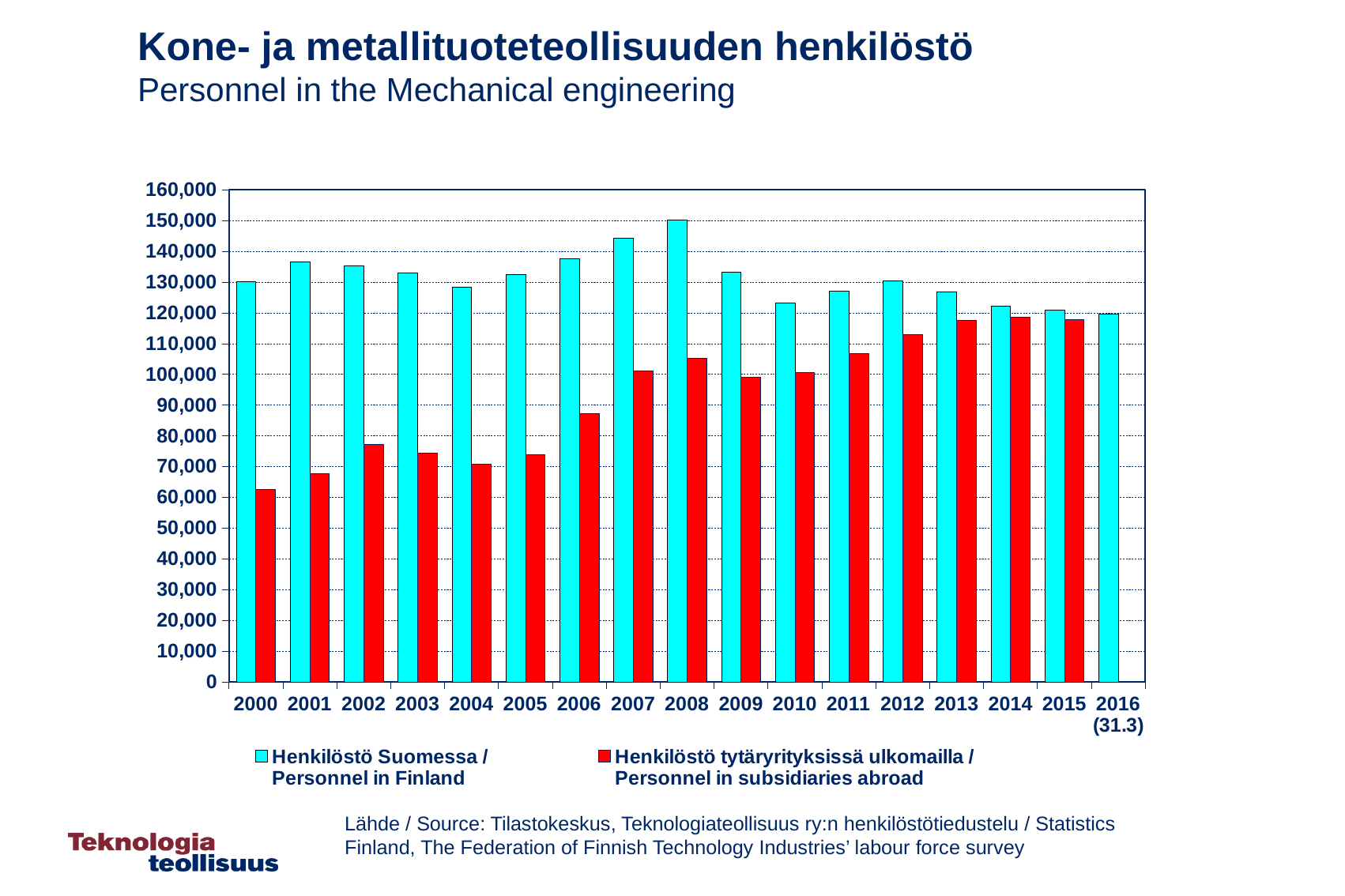
Is the value for Personnel in subsidiaries abroad in 2000 greater or less than 70,000? less What kind of chart is shown on the slide? bar chart Is the value for Personnel in subsidiaries abroad in 2006 greater or less than 90,000? less In which year is Personnel in Finland highest? 2008 In which year is Personnel in subsidiaries abroad lowest? 2000 Is the value for Personnel in subsidiaries abroad in 2012 greater or less than 110,000? greater Does Personnel in subsidiaries abroad rise or fall from 2000 to 2008? rise How many years are shown on the x axis? 17 Which is larger: Personnel in Finland in 2001 or in 2004? 2001 How many series does the legend list? 2 Which colour represents Personnel in Finland in the chart? cyan